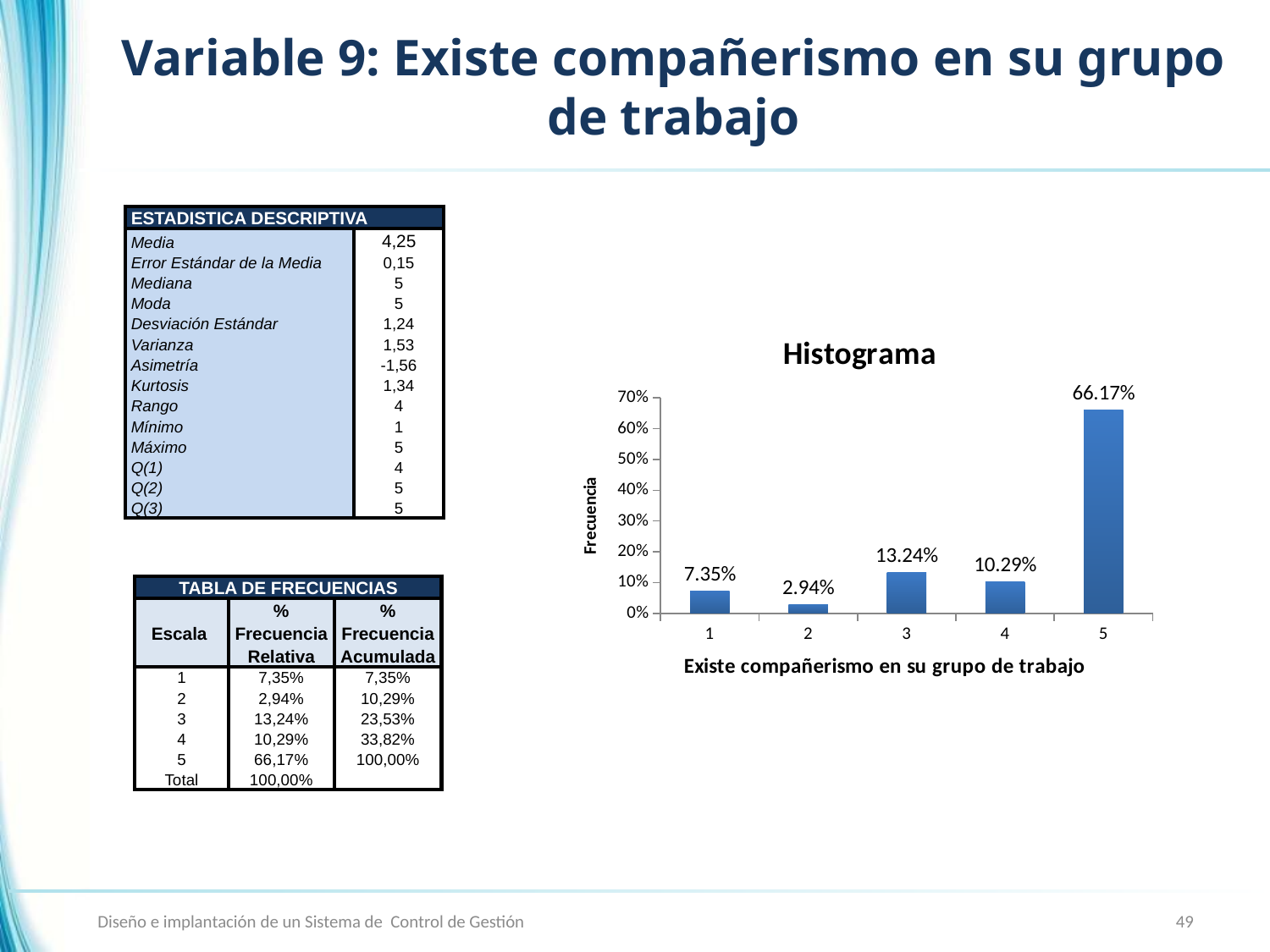
What is the y-axis label of the Histograma chart? Frecuencia Which is larger in the Histograma chart, the value for category 1 or category 2? category 1 Which category has the lowest value in the Histograma chart? 2 What kind of chart is the Histograma chart? bar chart Is the value for category 5 in the Histograma chart greater or less than 60%? greater What is the value for category 5 in the Histograma chart? 66.17% What is the difference between the values for category 3 and category 4 in the Histograma chart? 2.95% What is the title of the chart on the slide? Histograma How many categories are shown on the x axis of the Histograma chart? 5 Which category has the highest value in the Histograma chart? 5 What is the value for category 1 in the Histograma chart? 7.35% What is the value for category 3 in the Histograma chart? 13.24%